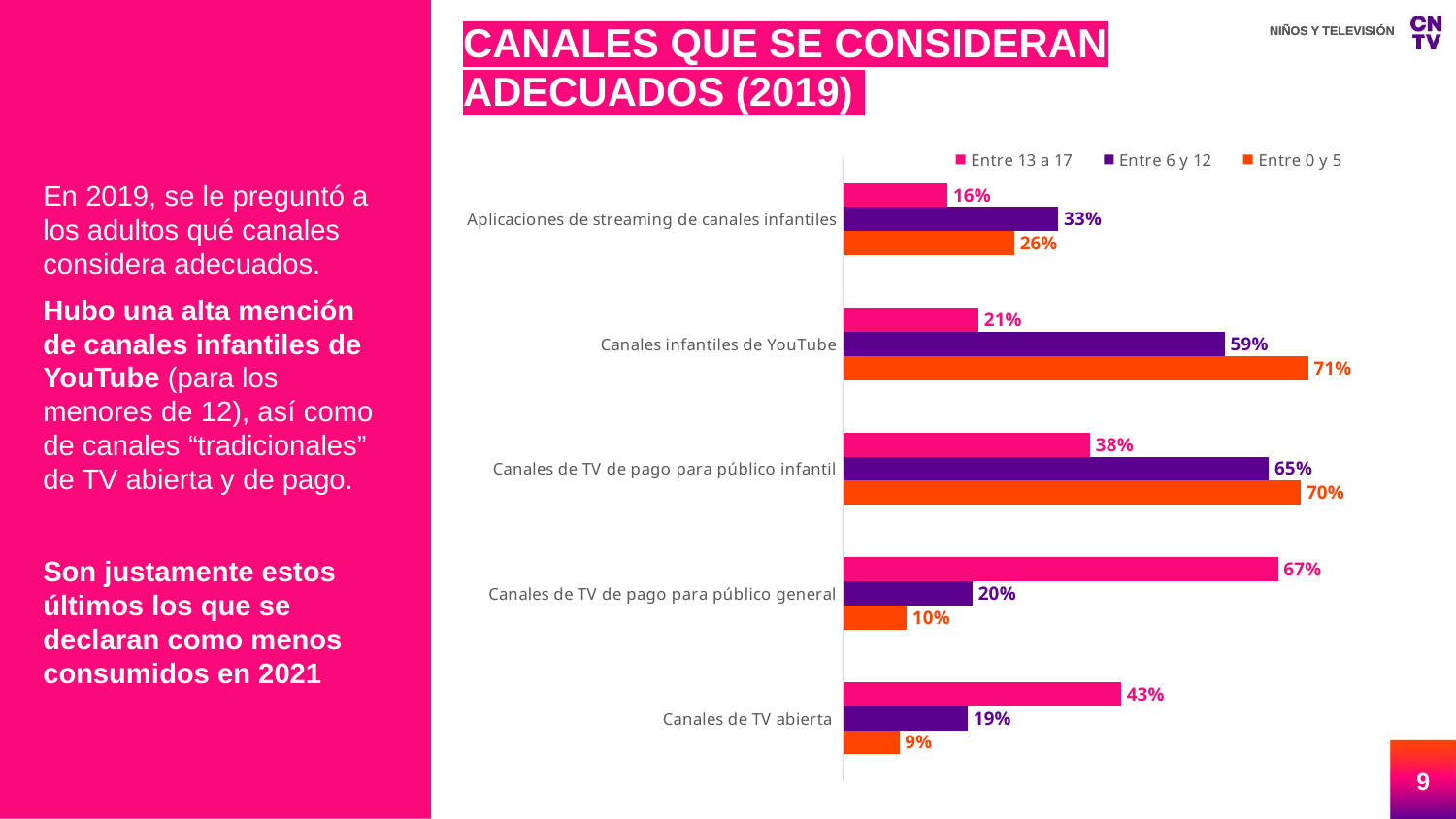
What is the value for 'Entre 6 y 12' for Aplicaciones de streaming de canales infantiles? 33% For Canales de TV de pago para público general, which is larger: the 'Entre 13 a 17' value or the 'Entre 6 y 12' value? Entre 13 a 17 Which category has the highest value for the 'Entre 6 y 12' series? Canales de TV de pago para público infantil What is the value for 'Entre 13 a 17' for Canales de TV de pago para público general? 67% What is the title of the chart on the slide? CANALES QUE SE CONSIDERAN ADECUADOS (2019) How many series does the legend list? 3 Which category has the lowest value for the 'Entre 13 a 17' series? Aplicaciones de streaming de canales infantiles What is the difference between the 'Entre 0 y 5' and 'Entre 13 a 17' values for Canales infantiles de YouTube? 50% What is the value for 'Entre 0 y 5' for Canales infantiles de YouTube? 71% What is the value for 'Entre 0 y 5' for Canales de TV abierta? 9% How many categories are shown on the chart? 5 What kind of chart is shown on the slide? Bar chart